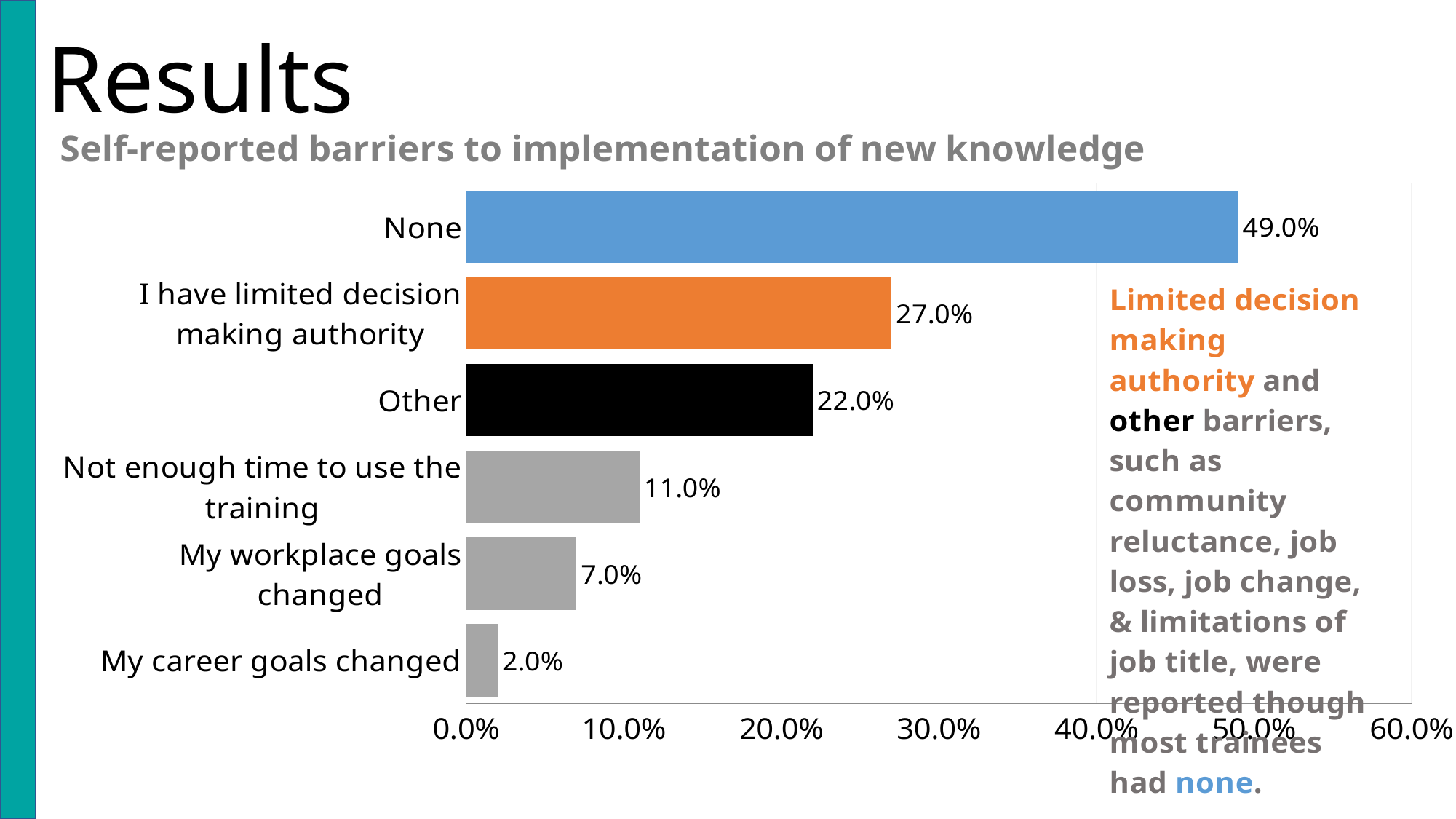
What is the value for 'My career goals changed'? 2.0% What is the value for 'Not enough time to use the training'? 11.0% Which is larger: 'Other' or 'My workplace goals changed'? Other What kind of chart is shown on the slide? bar chart What percentage of respondents reported 'None' as a barrier? 49.0% Which category has the highest value? None What is the value for 'I have limited decision making authority'? 27.0% Is the value for 'I have limited decision making authority' greater or less than 30.0%? less What is the title of the chart? Self-reported barriers to implementation of new knowledge What is the difference between the values for 'None' and 'Other'? 27.0% Which category has the lowest value? My career goals changed How many categories are shown in the chart? 6